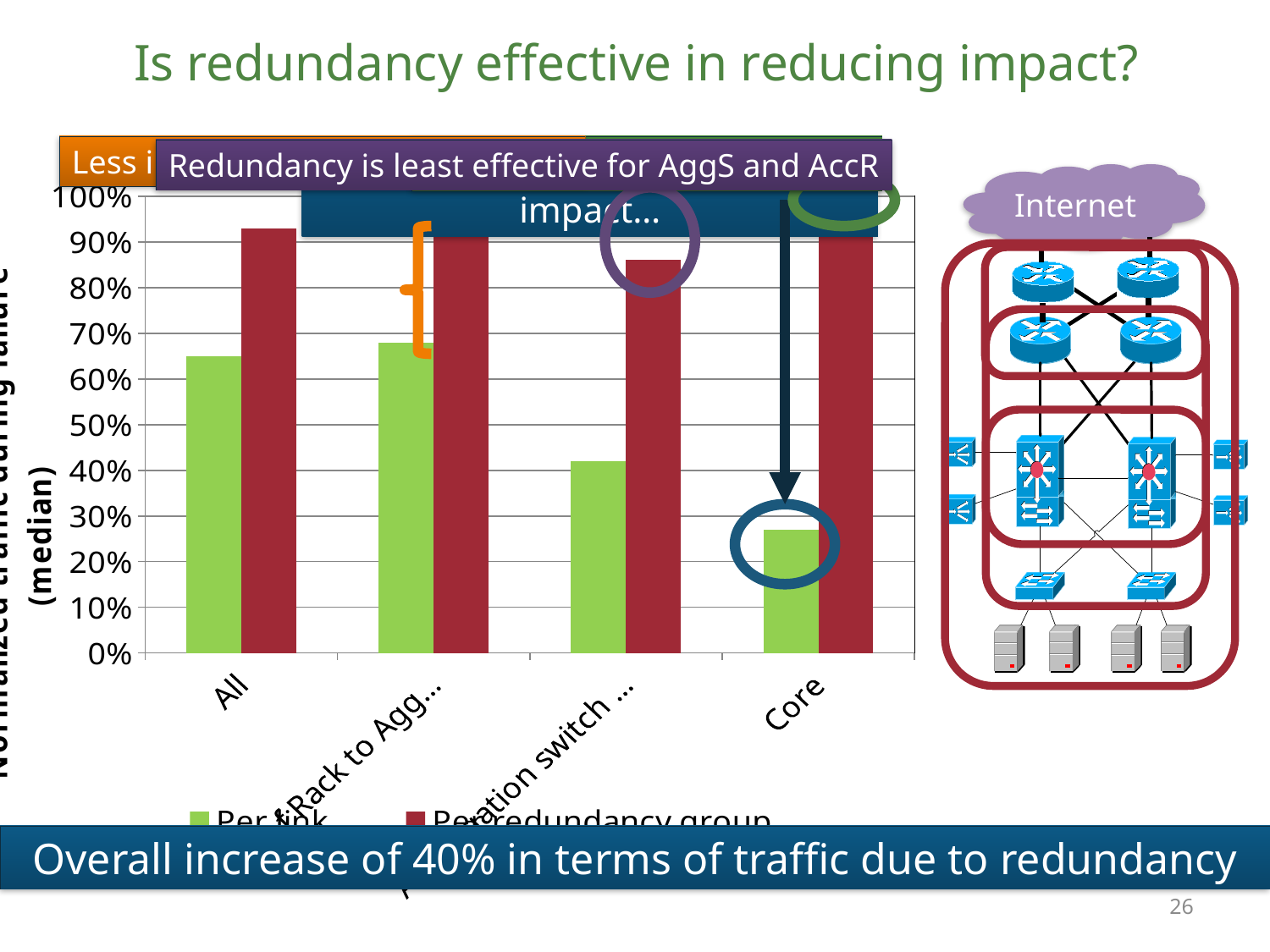
Is the Per redundancy group value for All greater or less than 80%? greater Is the Per redundancy group value for Core greater or less than 80%? greater Which category has the lowest Per link value? Core How many categories are plotted along the x axis of the chart? 4 What is the title of the slide containing the chart? Is redundancy effective in reducing impact? Is the Per link value for All greater or less than 60%? greater How many series does the chart legend list? 2 What kind of chart is shown on the slide? bar chart Which is larger: the Per link value for All or the Per link value for Core? All What colour are the Per link bars in the chart? green For the All category, which is larger: the Per link value or the Per redundancy group value? Per redundancy group